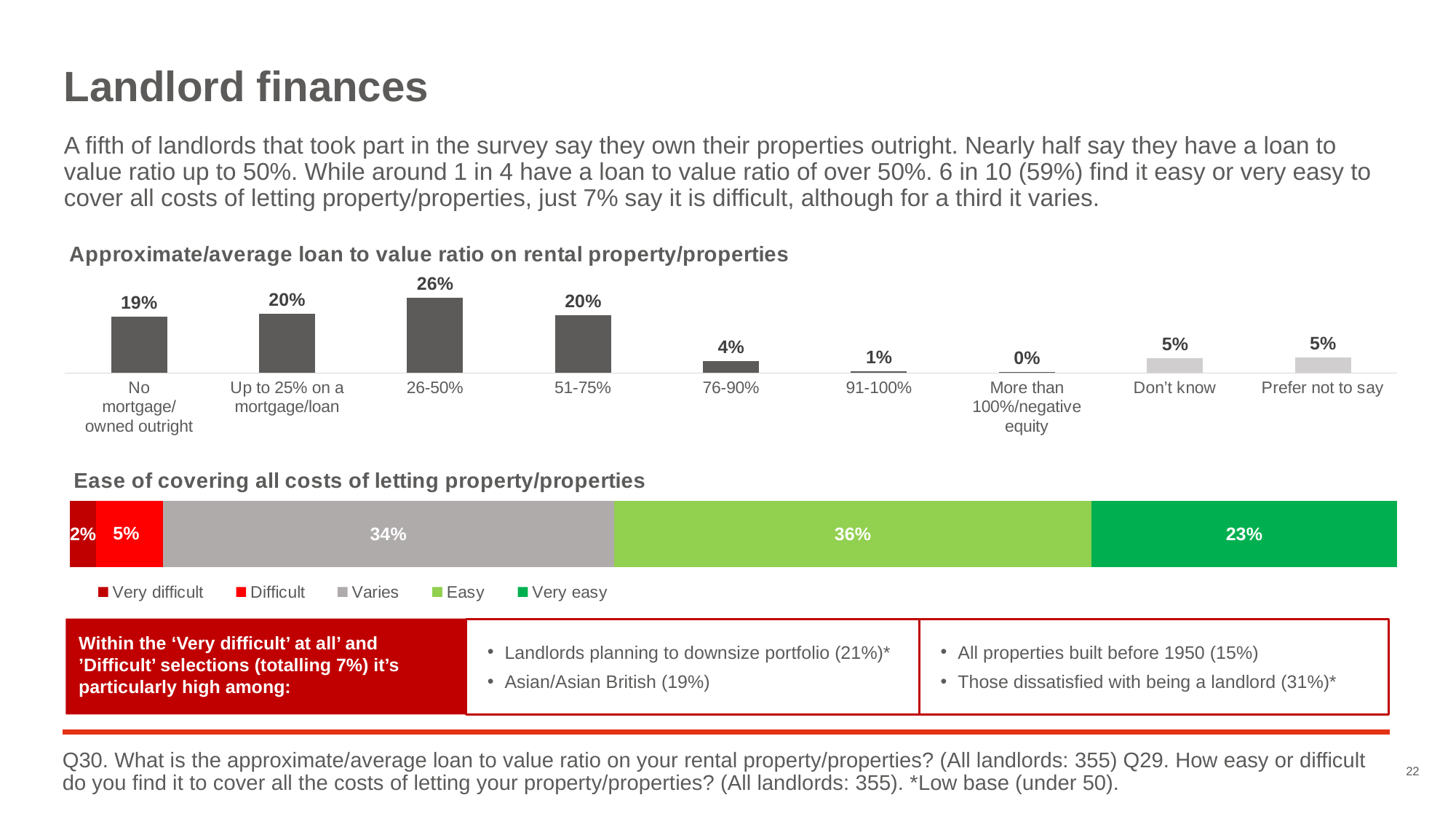
In the 'Approximate/average loan to value ratio on rental property/properties' chart, what is the value for 'No mortgage/owned outright'? 19% In the 'Approximate/average loan to value ratio on rental property/properties' chart, what is the value for 26-50%? 26% In the 'Approximate/average loan to value ratio on rental property/properties' chart, which category has the lowest value? More than 100%/negative equity In the 'Ease of covering all costs of letting property/properties' chart, what is the value for 'Very difficult'? 2% What kind of chart is the 'Approximate/average loan to value ratio on rental property/properties' chart? Bar chart In the 'Approximate/average loan to value ratio on rental property/properties' chart, what is the difference between the values for 26-50% and 76-90%? 22 percentage points In the 'Ease of covering all costs of letting property/properties' chart, what is the combined total of 'Easy' and 'Very easy'? 59% How many series does the legend of the 'Ease of covering all costs of letting property/properties' chart list? 5 In the 'Approximate/average loan to value ratio on rental property/properties' chart, which category has the highest value? 26-50% In the 'Approximate/average loan to value ratio on rental property/properties' chart, which is larger: the value for 51-75% or the value for 91-100%? 51-75% In the 'Ease of covering all costs of letting property/properties' chart, what is the value for 'Easy'? 36% How many categories are shown in the 'Approximate/average loan to value ratio on rental property/properties' chart? 9